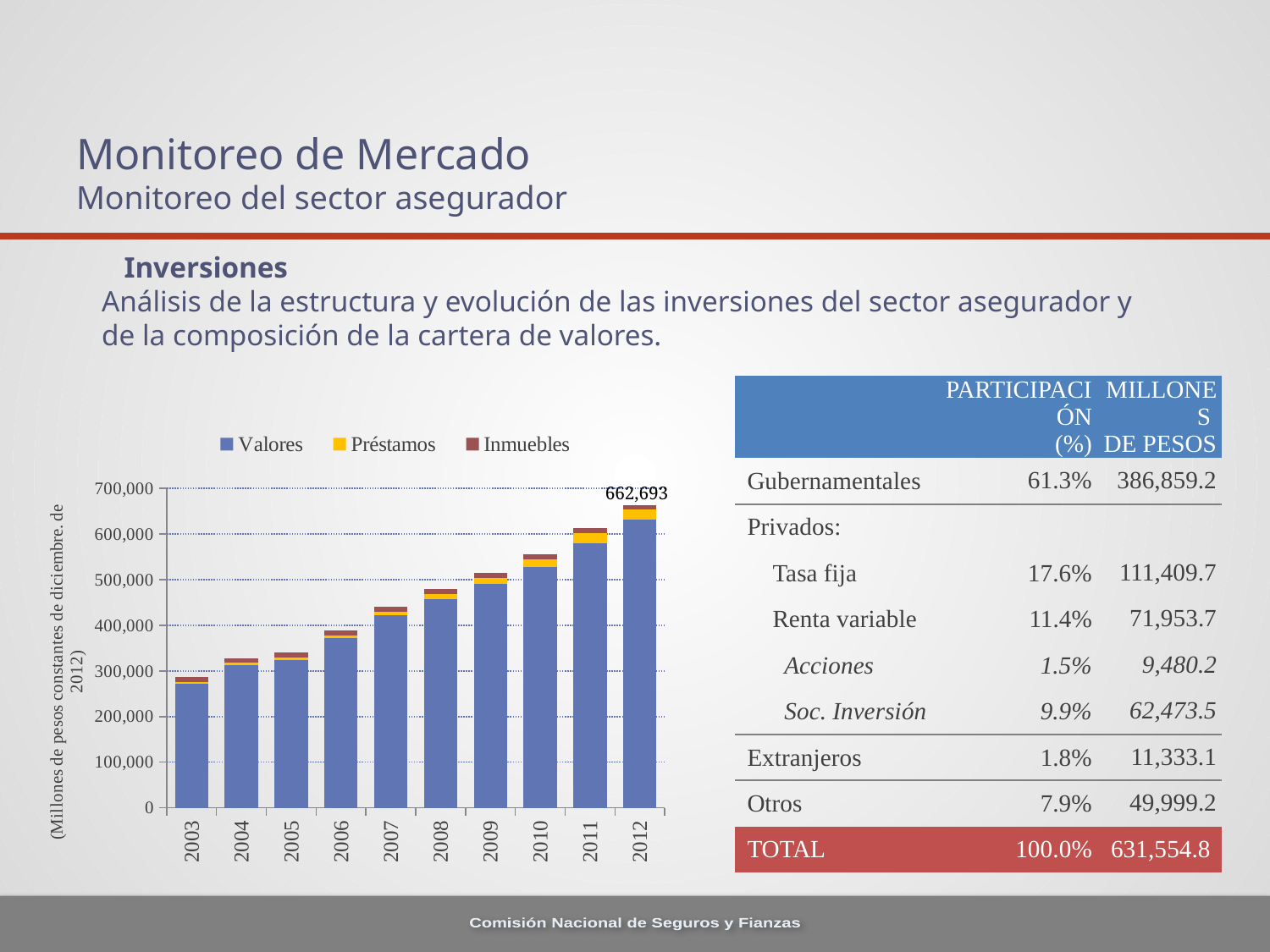
Which year has the lowest total bar in the chart? 2003 How many years are shown on the x axis of the chart? 10 Is the total value for 2010 greater or less than 500,000? greater Which series makes up the largest part of each bar in the chart? Valores How many series does the chart legend list? 3 Is the total value for 2007 greater or less than 400,000? greater Do the total bar values rise or fall from 2003 to 2012? rise Which series is shown in yellow in the chart legend? Préstamos Which year has the highest total bar in the chart? 2012 What is the total value labelled on the 2012 bar? 662,693 What kind of chart is shown on the slide? stacked bar chart Is the total value for 2008 greater or less than 500,000? less